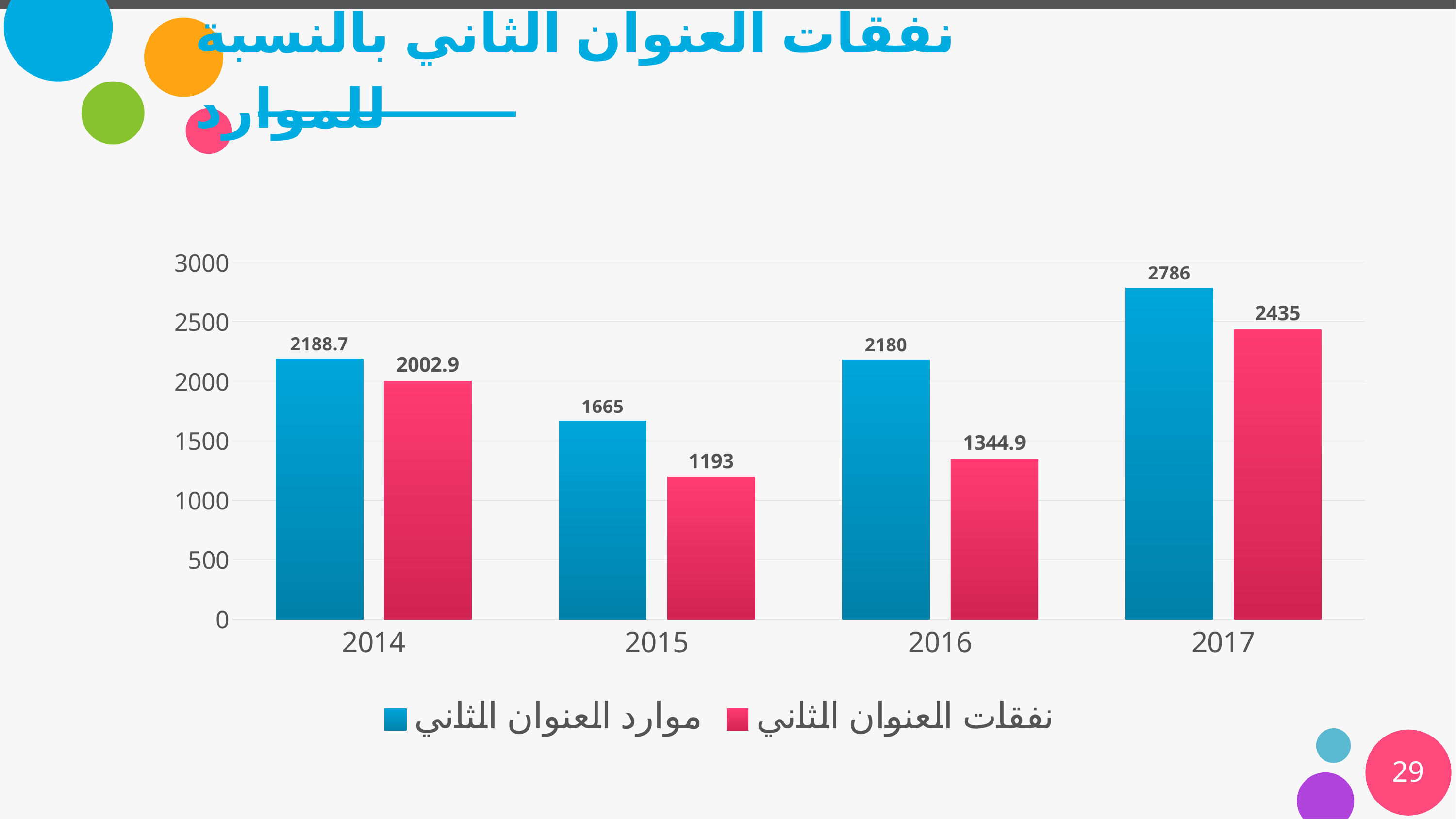
What is the value of موارد العنوان الثاني for 2014? 2188.7 Which is larger in 2016: موارد العنوان الثاني or نفقات العنوان الثاني? موارد العنوان الثاني Which colour represents نفقات العنوان الثاني in the legend? pink In which year is موارد العنوان الثاني highest? 2017 Is the value of نفقات العنوان الثاني for 2014 greater or less than 1500? greater What is the value of نفقات العنوان الثاني for 2016? 1344.9 What is the difference between موارد العنوان الثاني and نفقات العنوان الثاني in 2017? 351 How many years are shown on the x axis? 4 What is the value of نفقات العنوان الثاني for 2015? 1193 What kind of chart is shown on the slide? bar chart How many series does the legend list? 2 In which year is نفقات العنوان الثاني lowest? 2015